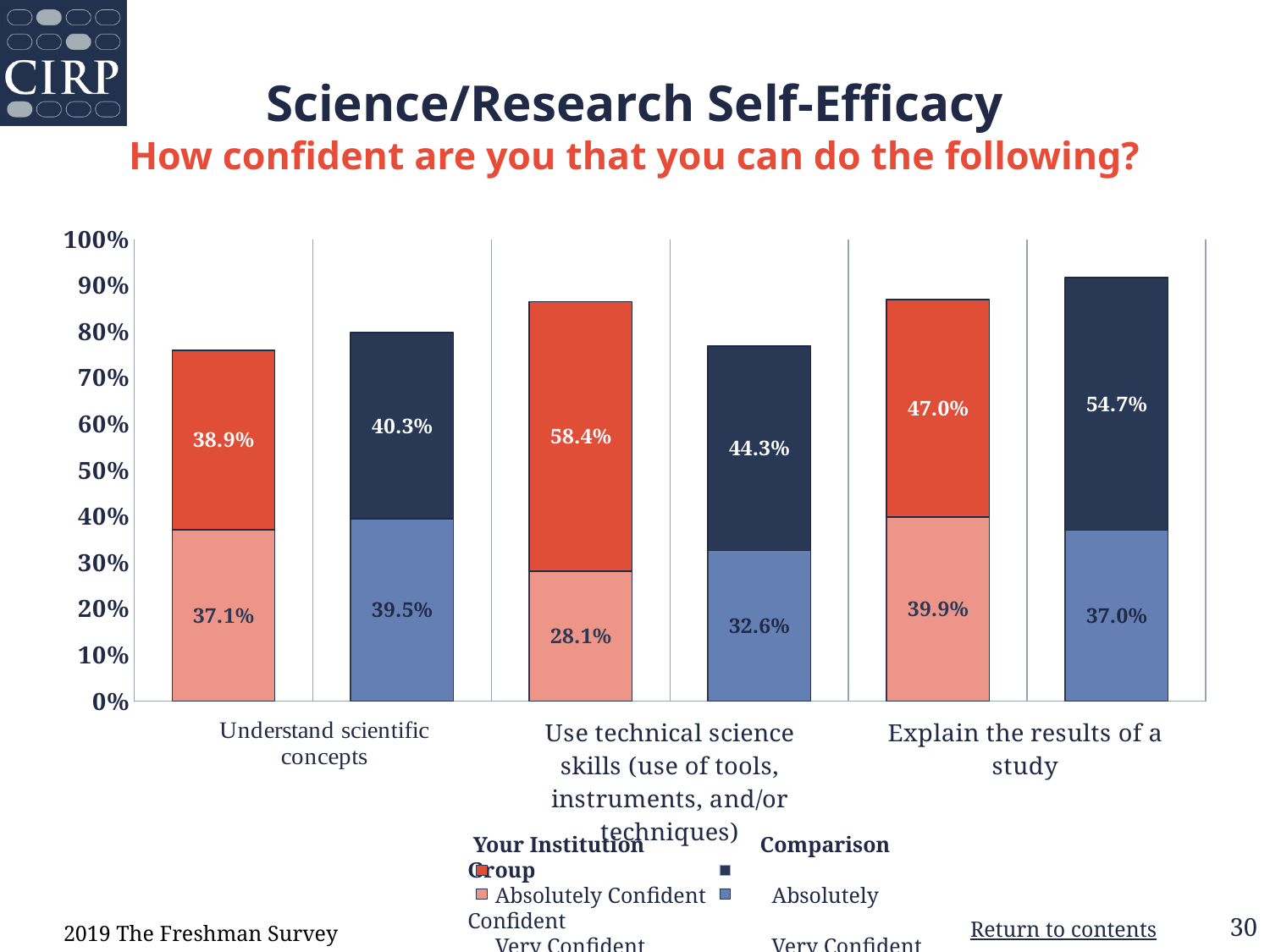
What is the value of the lower (light blue) segment of the Comparison Group bar for "Use technical science skills"? 32.6% How many categories are shown on the x axis of the chart? 3 What is the total of the Your Institution stacked bar for "Explain the results of a study"? 86.9% What is the total of the Comparison Group stacked bar for "Understand scientific concepts"? 79.8% For "Explain the results of a study", is the upper segment larger for Your Institution or the Comparison Group? Comparison Group Which single segment value shown on the chart is the smallest? 28.1% Which single segment value shown on the chart is the largest? 58.4% What is the difference between the upper segments of the Your Institution and Comparison Group bars for "Use technical science skills" (58.4% vs 44.3%)? 14.1% What is the value of the lower (light red) segment of the Your Institution bar for "Understand scientific concepts"? 37.1% What is the value of the upper (dark blue) segment of the Comparison Group bar for "Explain the results of a study"? 54.7% What is the value of the upper (dark red) segment of the Your Institution bar for "Use technical science skills"? 58.4% Is the total height of the Comparison Group bar for "Explain the results of a study" greater or less than 90%? greater